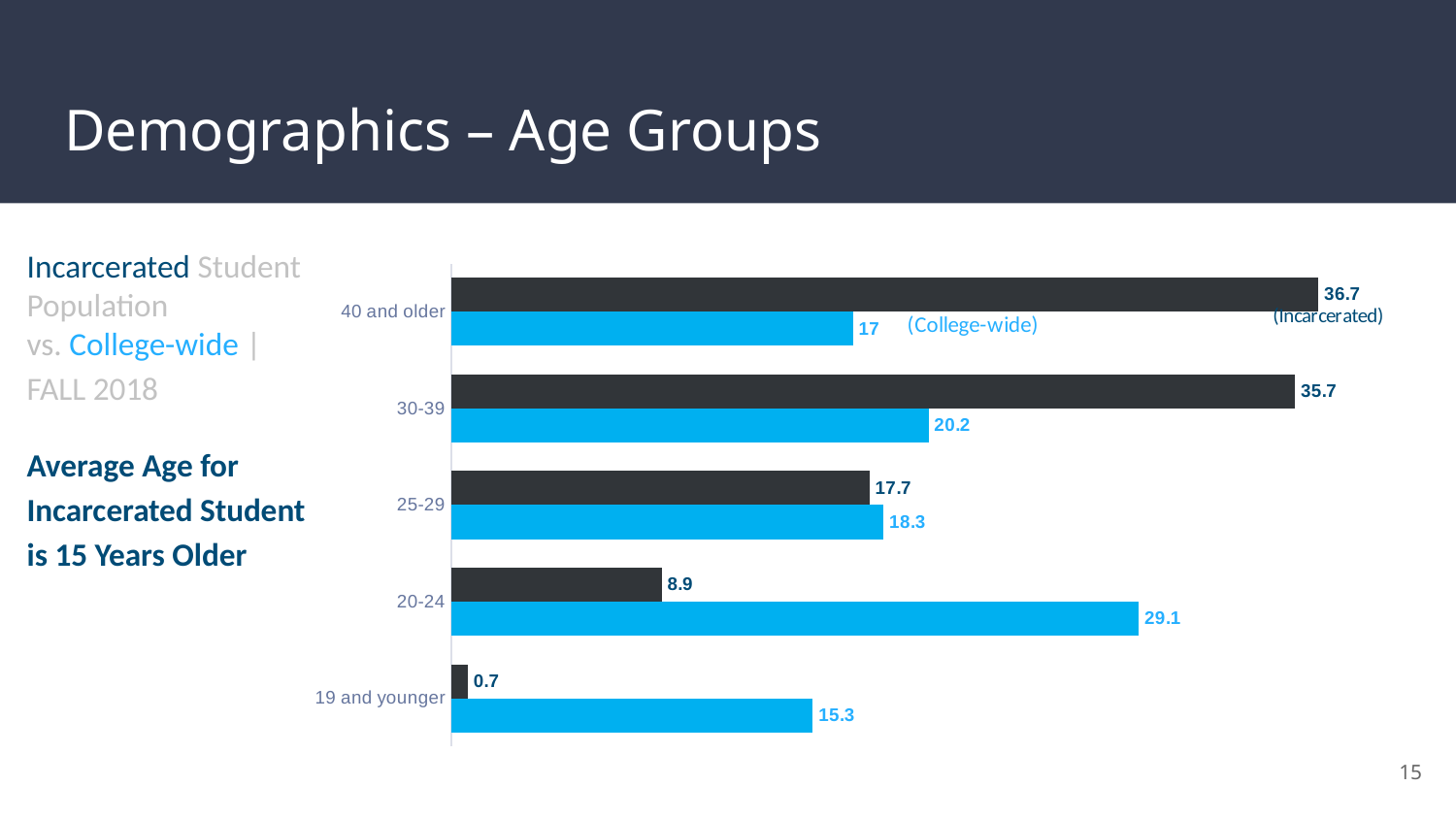
For the 25-29 age group, which is larger: the Incarcerated value or the College-wide value? College-wide What is the Incarcerated value for the 19 and younger age group? 0.7 Which age group has the highest Incarcerated value? 40 and older What is the difference between the College-wide and Incarcerated values for the 20-24 age group? 20.2 What is the Incarcerated value for the 40 and older age group? 36.7 What is the difference between the Incarcerated and College-wide values for the 30-39 age group? 15.5 Which age group has the lowest College-wide value? 19 and younger What is the College-wide value for the 20-24 age group? 29.1 Which colour represents the College-wide series in the chart? Light blue How many data series does the chart show? 2 How many age groups are shown in the chart? 5 What kind of chart is shown on the slide? Bar chart